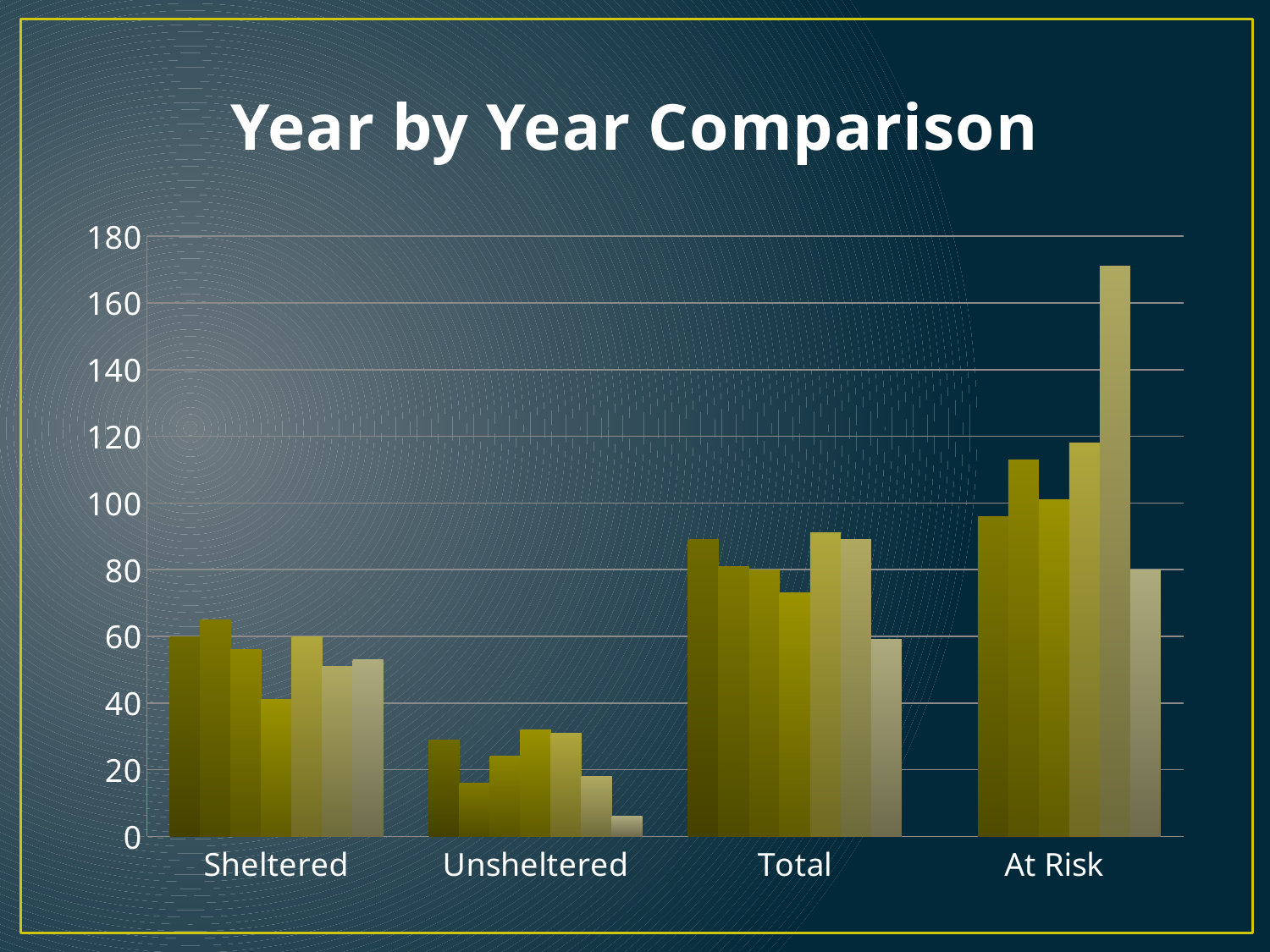
What kind of chart is shown on the slide? bar chart Which category has taller bars overall, Total or Sheltered? Total Is the shortest bar in the Unsheltered category greater or less than 20? less How many categories are shown on the x axis? 4 Is the tallest bar in the Total category greater or less than 100? less What is the highest value shown on the vertical axis? 180 Which category contains the shortest bar in the chart? Unsheltered Which category contains the tallest bar in the chart? At Risk Is the tallest bar in the Sheltered category greater or less than 80? less What is the title of the chart? Year by Year Comparison